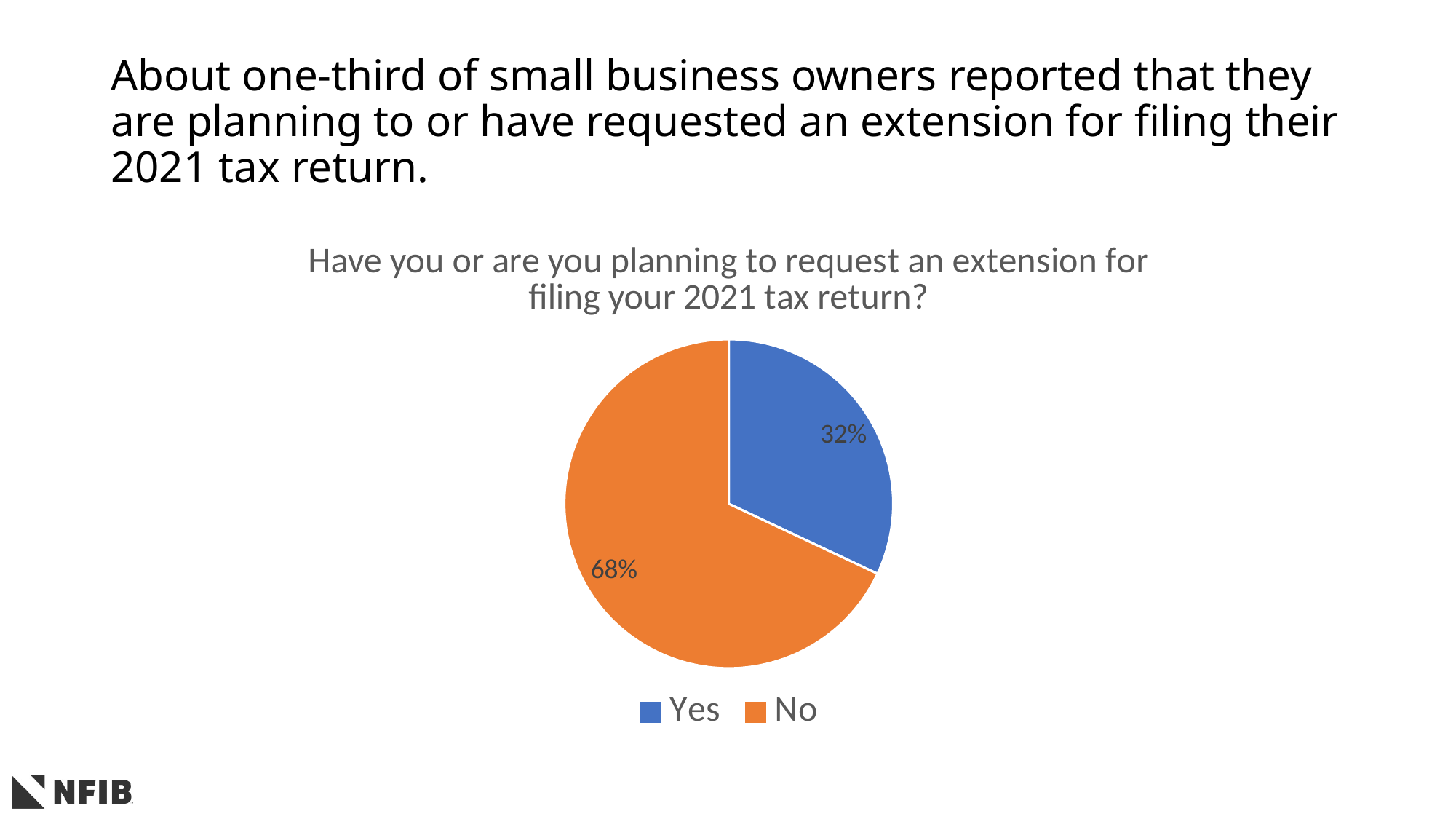
What colour is the "No" slice? Orange Which slice is larger, "Yes" or "No"? No What is the difference in percentage points between the "No" and "Yes" slices? 36 What share of the pie does the "Yes" slice represent? 32% What kind of chart is shown on the slide? Pie chart Which response has the largest share of the pie? No How many slices does the pie chart have? 2 What is the title of the chart? Have you or are you planning to request an extension for filing your 2021 tax return? What percentage of respondents answered "Yes"? 32% What percentage of respondents answered "No"? 68% Which response has the smallest share of the pie? Yes How many entries does the legend list? 2